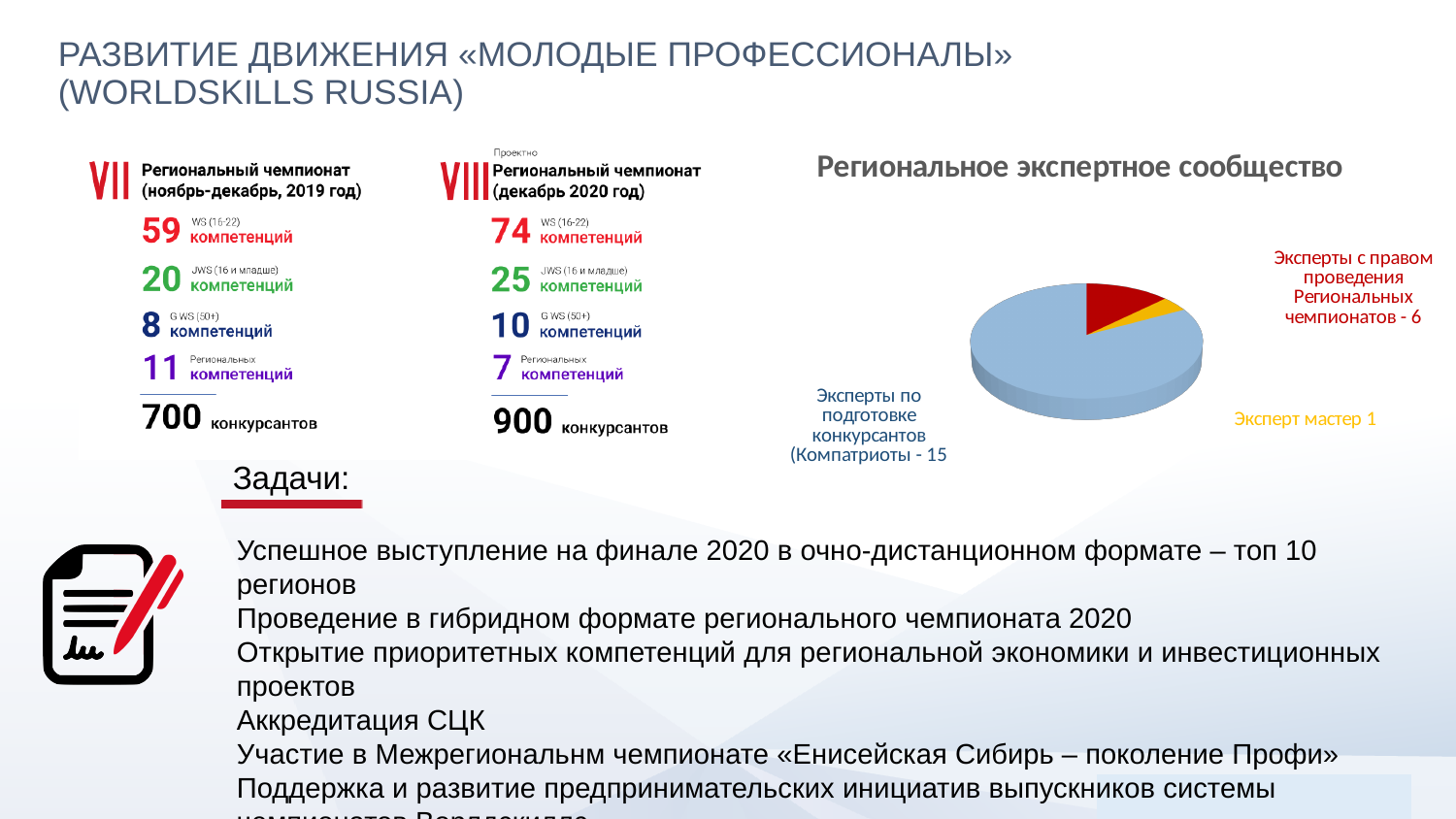
In the pie chart «Региональное экспертное сообщество», how many experts are in the category «Эксперты по подготовке конкурсантов (Компатриоты)»? 15 What is the title of the pie chart on the slide? Региональное экспертное сообщество In the pie chart «Региональное экспертное сообщество», which is larger: «Эксперты с правом проведения Региональных чемпионатов» or «Эксперт мастер»? Эксперты с правом проведения Региональных чемпионатов What kind of chart is shown under the title «Региональное экспертное сообщество»? pie chart Which category has the smallest slice in the pie chart «Региональное экспертное сообщество»? Эксперт мастер In the pie chart «Региональное экспертное сообщество», what is the value for «Эксперт мастер»? 1 In the pie chart «Региональное экспертное сообщество», what is the difference between «Эксперты с правом проведения Региональных чемпионатов» and «Эксперт мастер»? 5 Which category has the largest slice in the pie chart «Региональное экспертное сообщество»? Эксперты по подготовке конкурсантов (Компатриоты) In the pie chart «Региональное экспертное сообщество», how many experts are in the category «Эксперты с правом проведения Региональных чемпионатов»? 6 What colour is the largest slice in the pie chart «Региональное экспертное сообщество»? light blue In the pie chart «Региональное экспертное сообщество», what is the difference between the number of «Эксперты по подготовке конкурсантов (Компатриоты)» and «Эксперты с правом проведения Региональных чемпионатов»? 9 How many slices does the pie chart «Региональное экспертное сообщество» have? 3